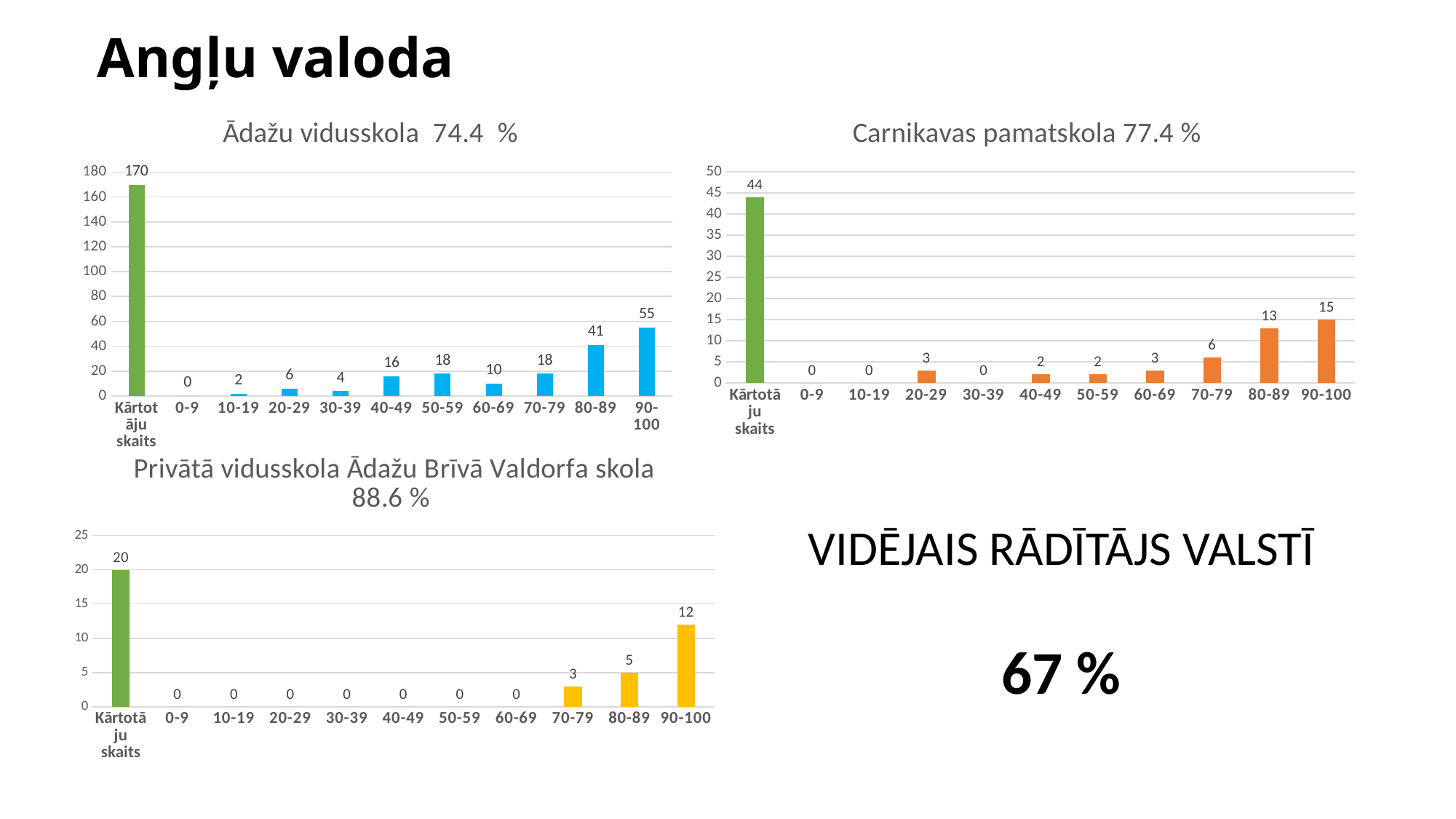
What colour are the bars for the score range categories in the 'Privātā vidusskola Ādažu Brīvā Valdorfa skola 88.6 %' chart? Yellow In the 'Carnikavas pamatskola 77.4 %' chart, what is the value for the 90-100 category? 15 In the 'Ādažu vidusskola 74.4 %' chart, what is the value for the 80-89 category? 41 In the 'Ādažu vidusskola 74.4 %' chart, how many categories are shown on the x axis? 11 In the 'Ādažu vidusskola 74.4 %' chart, what is the value for 'Kārtotāju skaits'? 170 In the 'Privātā vidusskola Ādažu Brīvā Valdorfa skola 88.6 %' chart, how many score range categories have a value of 0? 7 In the 'Privātā vidusskola Ādažu Brīvā Valdorfa skola 88.6 %' chart, what is the value for the 80-89 category? 5 In the 'Carnikavas pamatskola 77.4 %' chart, what is the total of the 80-89 and 90-100 values? 28 In the 'Carnikavas pamatskola 77.4 %' chart, which score range category (excluding 'Kārtotāju skaits') has the highest value? 90-100 In the 'Carnikavas pamatskola 77.4 %' chart, which is larger, the value for 70-79 or the value for 80-89? 80-89 What kind of chart is the 'Ādažu vidusskola 74.4 %' chart? Bar chart In the 'Ādažu vidusskola 74.4 %' chart, what is the difference between the 90-100 and 80-89 values? 14